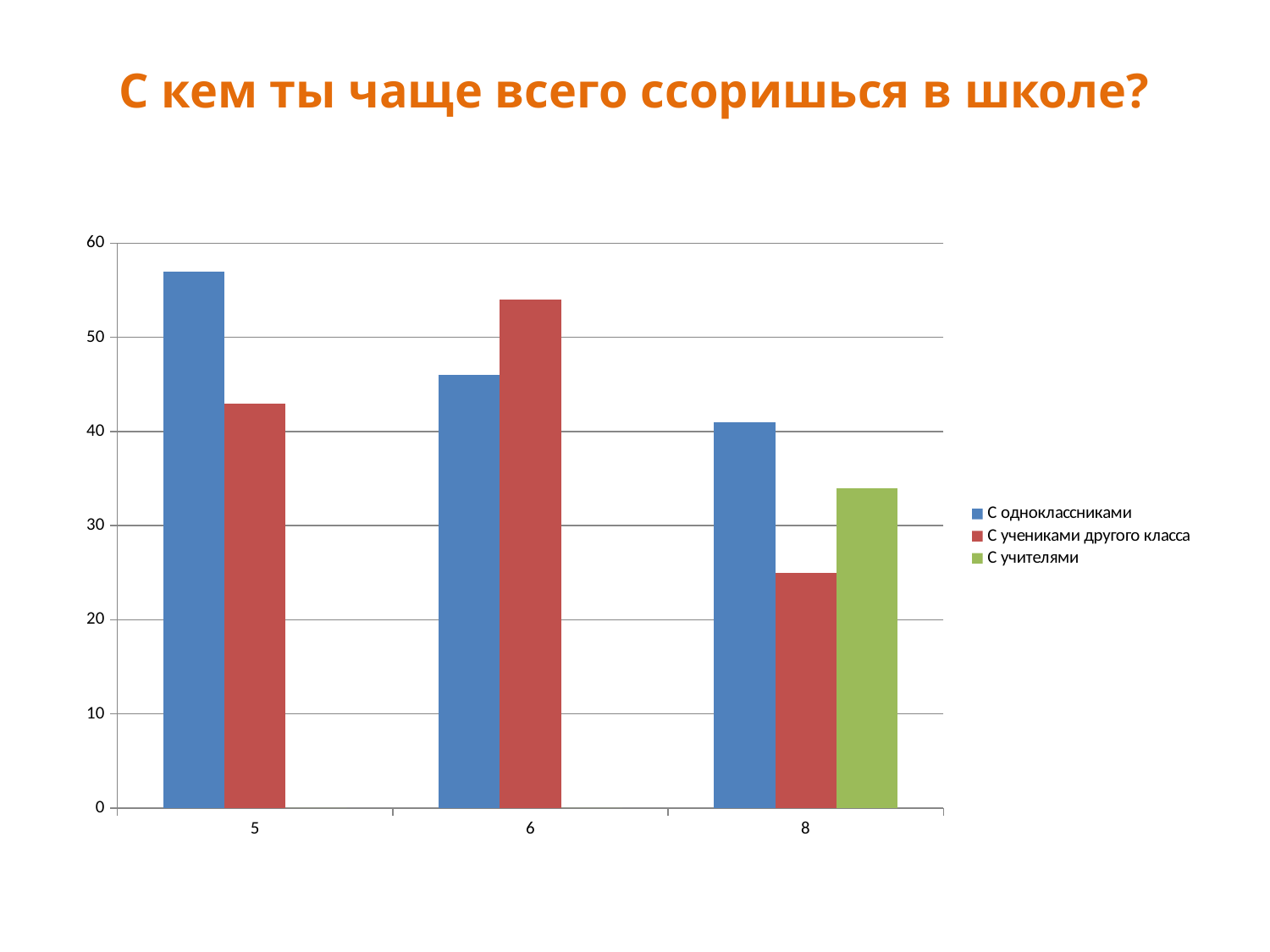
How many categories are shown on the x axis? 3 Do the values for 'С одноклассниками' rise or fall across the categories from 5 to 8? fall How many series does the legend list? 3 Is the value for 'С учениками другого класса' in category 8 greater or less than 30? less In category 6, which is larger: 'С одноклассниками' or 'С учениками другого класса'? С учениками другого класса Is the value for 'С учителями' in category 8 greater or less than 30? greater Is the value for 'С учениками другого класса' in category 6 greater or less than 50? greater What kind of chart is shown on the slide? bar chart In category 5, which is larger: 'С одноклассниками' or 'С учениками другого класса'? С одноклассниками What is the title of the chart? С кем ты чаще всего ссоришься в школе? Which category has the highest value for 'С одноклассниками'? 5